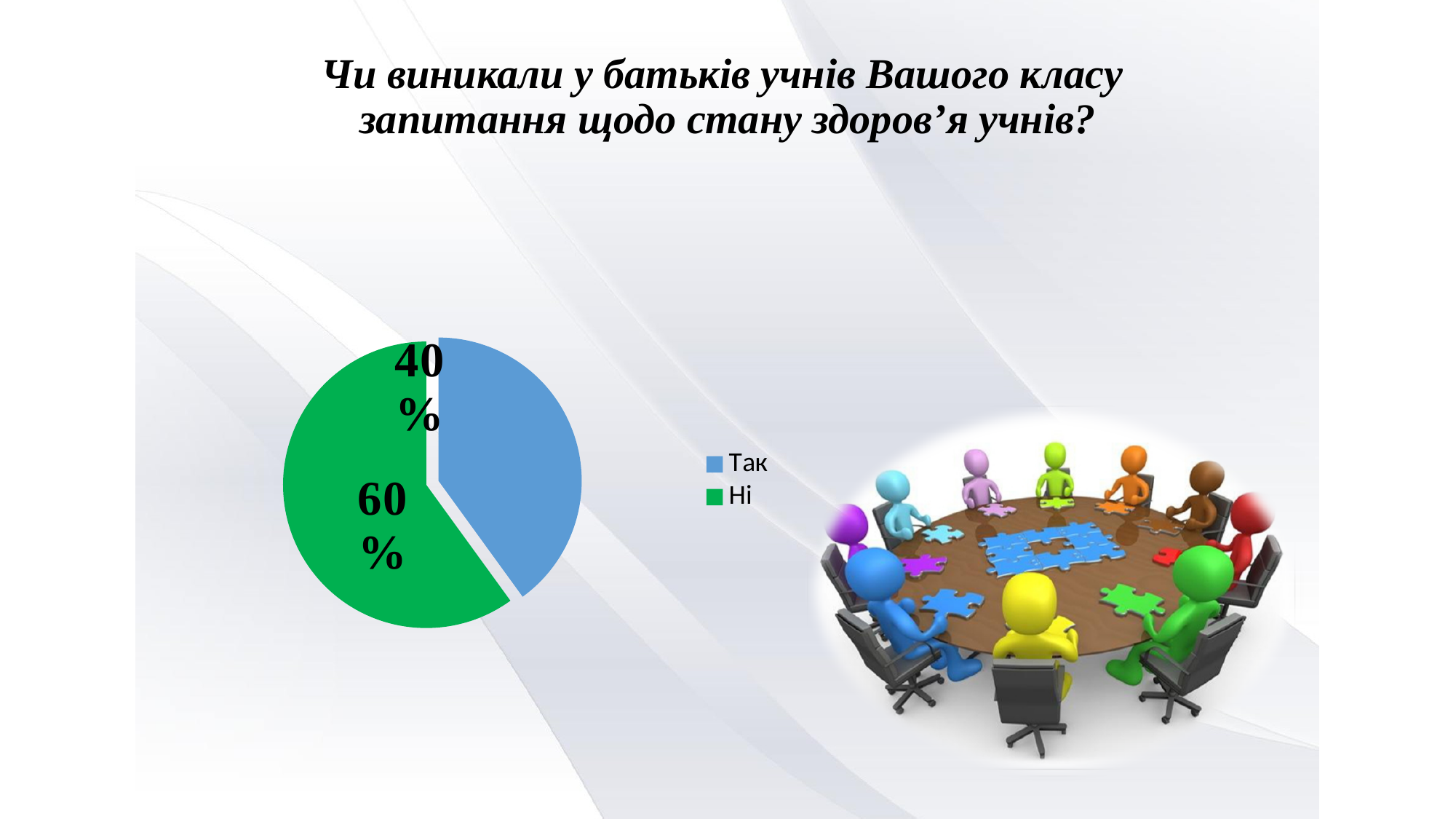
What kind of chart is shown on the slide? pie chart Is the share for "Ні" greater or less than 50%? greater What is the difference between the shares for "Ні" and "Так"? 20% How many entries does the legend list? 2 What colour is the "Так" slice? blue What share of the pie does "Ні" have? 60% How many slices does the pie chart have? 2 What share of the pie does "Так" have? 40% Which slice of the pie is the smallest? Так Which slice of the pie is the largest? Ні What colour is the "Ні" slice? green Which is larger, the share for "Так" or the share for "Ні"? Ні